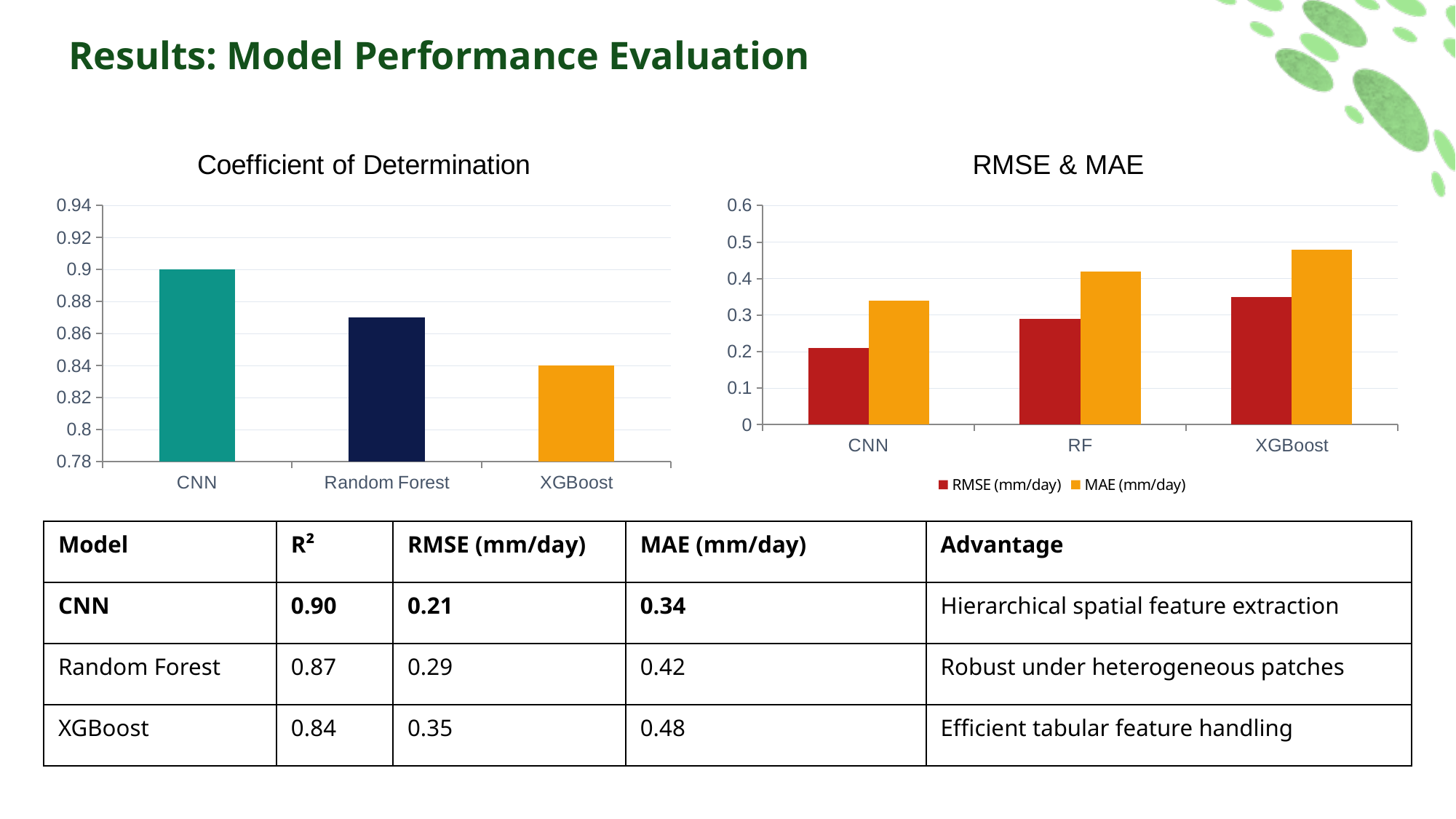
In the RMSE & MAE chart, what is the RMSE value for CNN? 0.21 In the Coefficient of Determination chart, which model has the lowest value? XGBoost In the RMSE & MAE chart, which model has the highest RMSE? XGBoost In the Coefficient of Determination chart, what is the value for CNN? 0.90 In the Coefficient of Determination chart, how many models are shown on the x axis? 3 In the Coefficient of Determination chart, which model has the highest value? CNN In the Coefficient of Determination chart, is the value for Random Forest greater or less than 0.86? greater In the RMSE & MAE chart, what is the MAE value for XGBoost? 0.48 What kind of chart is the RMSE & MAE chart? bar chart In the RMSE & MAE chart, how many series does the legend list? 2 In the RMSE & MAE chart, what is the difference between the MAE and RMSE values for RF? 0.13 In the RMSE & MAE chart, is the MAE value for RF greater or less than 0.4? greater